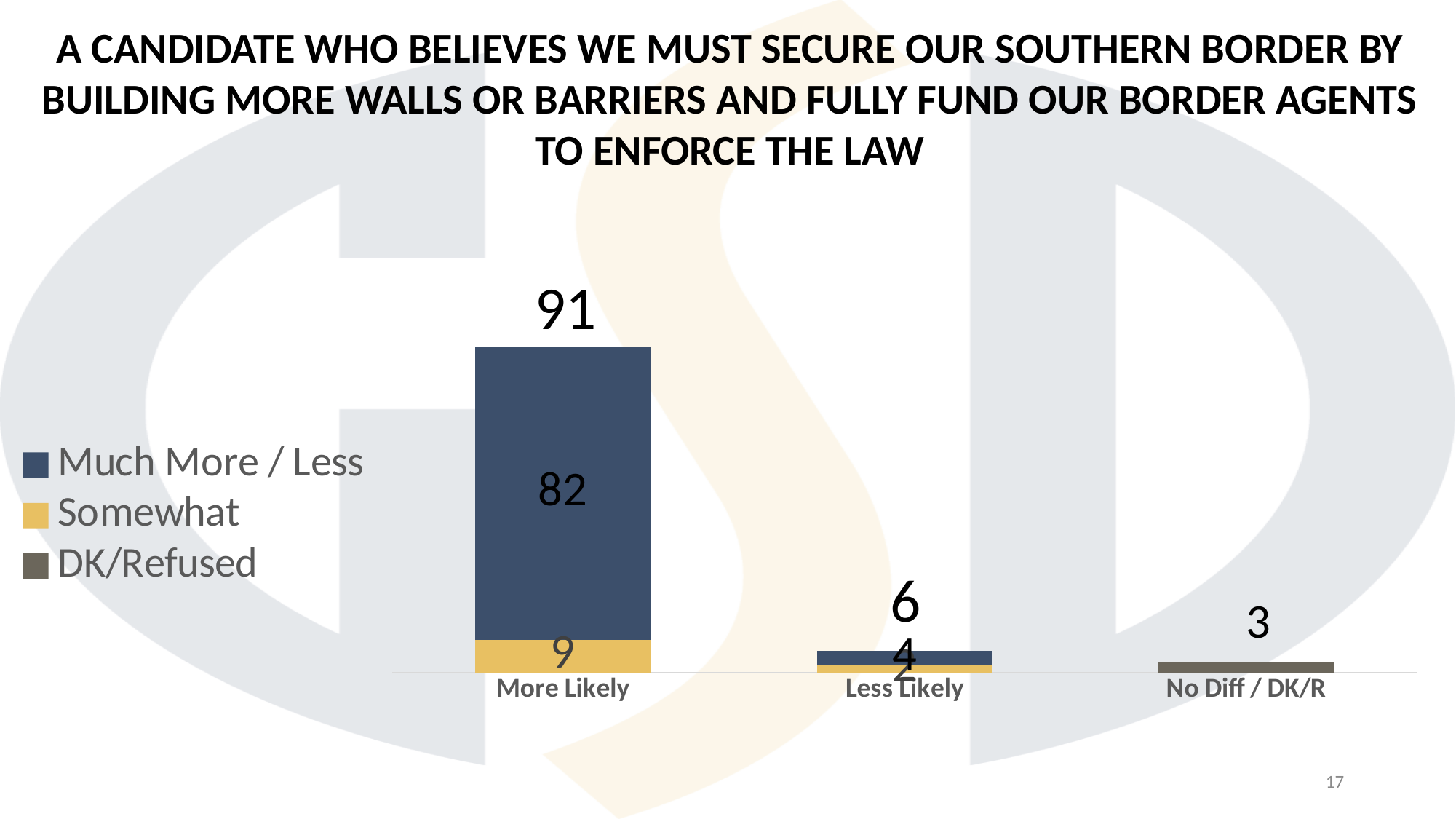
What is the value for No Diff / DK/R? 3 What is the total value shown above the More Likely bar? 91 How many series does the legend list? 3 What is the Somewhat value for More Likely? 9 What is the Much More / Less value for More Likely? 82 Which category has the lowest total? No Diff / DK/R What is the Much More / Less value for Less Likely? 4 What is the difference between the More Likely total and the Less Likely total? 85 What is the total value shown above the Less Likely bar? 6 Which category has the highest total? More Likely Which is larger, the Much More / Less value for More Likely or the Somewhat value for More Likely? Much More / Less How many categories are shown on the x axis? 3